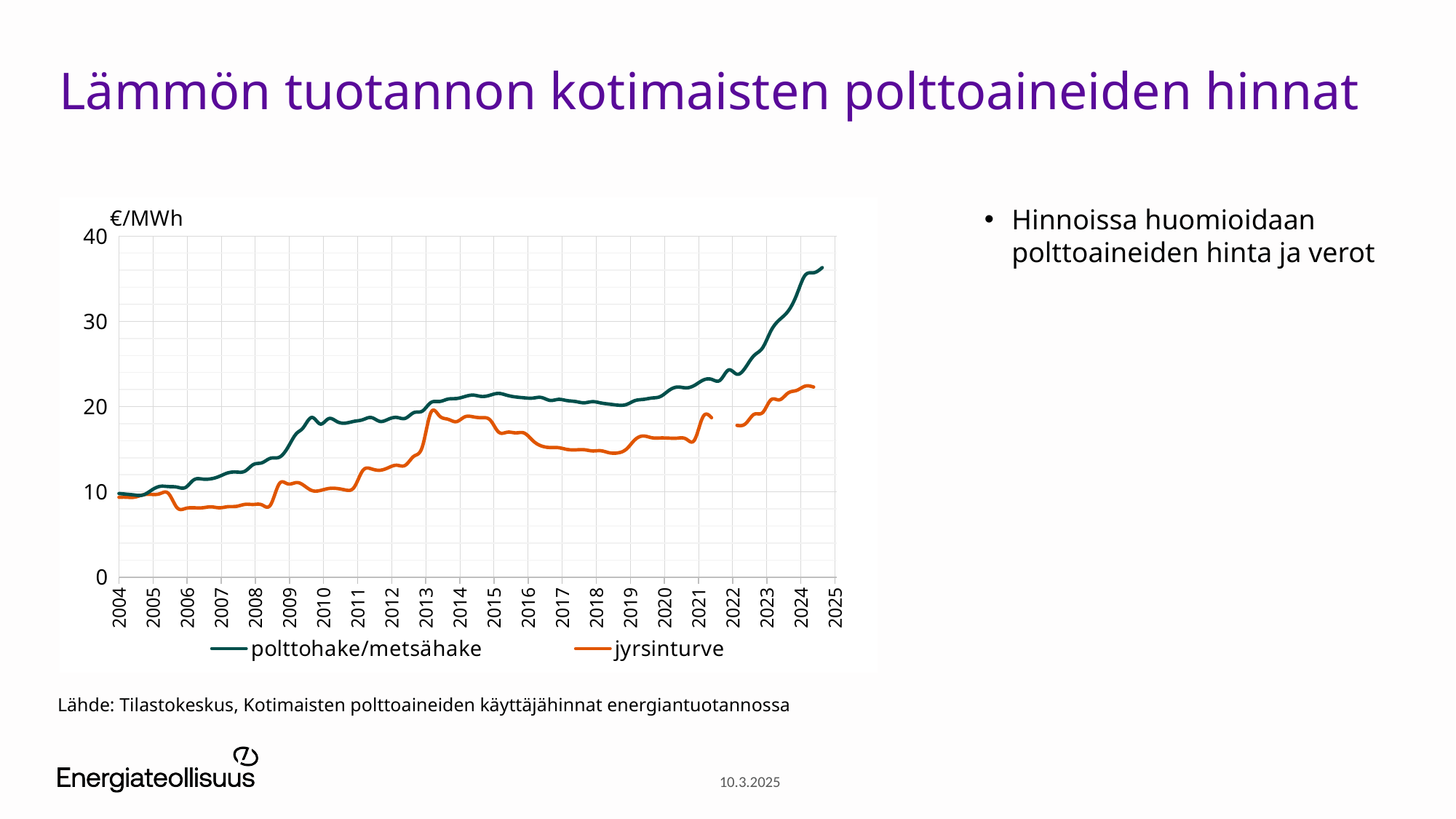
Is the value for jyrsinturve at the end of 2024 greater or less than 20? greater Does the polttohake/metsähake line rise or fall between 2021 and 2024? rise What kind of chart is shown on the slide? line chart Is the value for jyrsinturve in 2006 greater or less than 10? less What are the two series named in the legend? polttohake/metsähake and jyrsinturve What unit is shown on the vertical axis of the chart? €/MWh Does the jyrsinturve line rise or fall between 2013 and 2018? fall How many series does the chart's legend list? 2 Is the value for polttohake/metsähake in 2004 greater or less than 20? less In 2010, which series has the higher value, polttohake/metsähake or jyrsinturve? polttohake/metsähake In 2024, which series has the higher value, polttohake/metsähake or jyrsinturve? polttohake/metsähake